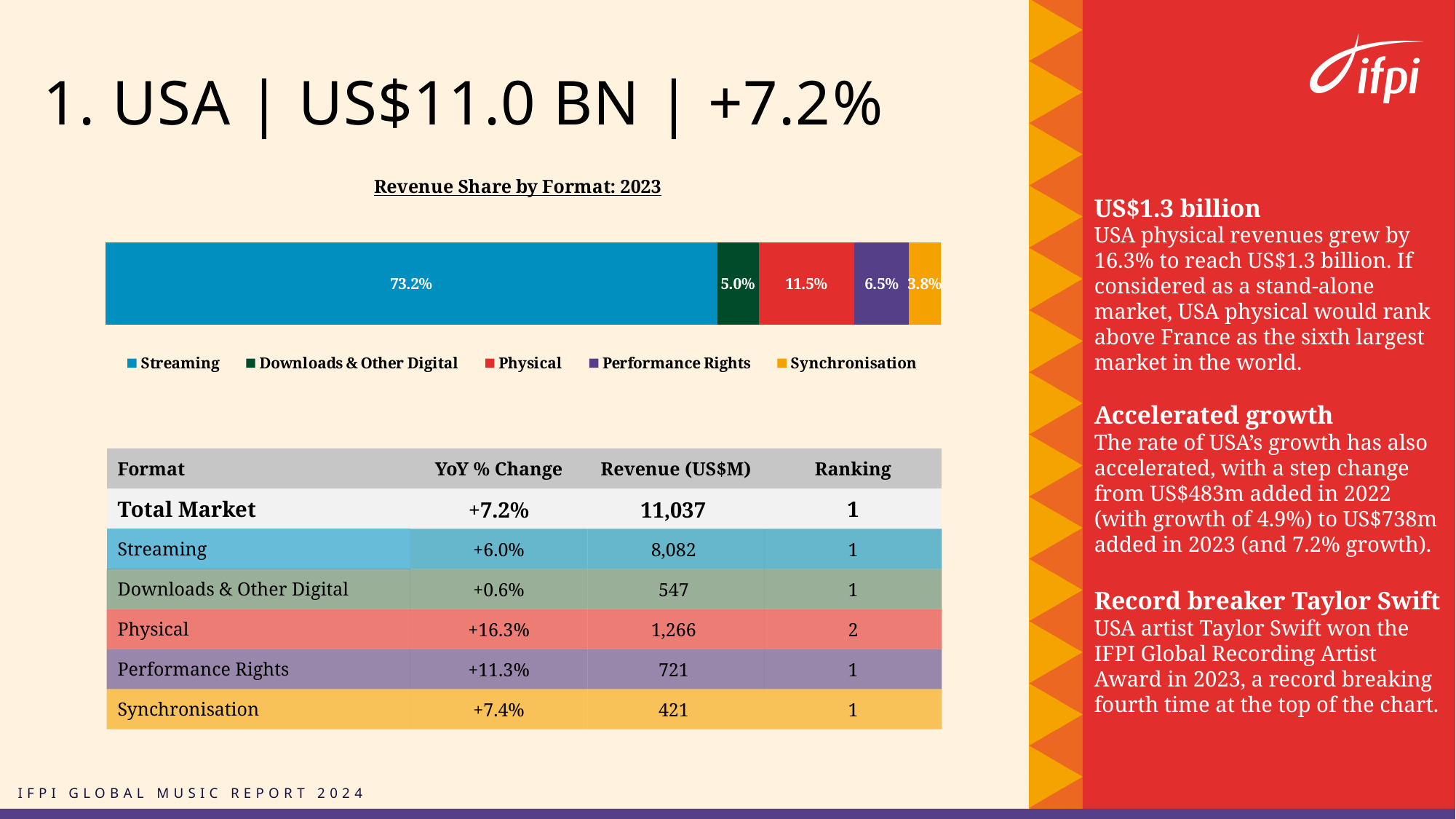
How many series does the legend of the Revenue Share by Format: 2023 chart list? 5 In the Revenue Share by Format: 2023 chart, what colour is the Synchronisation segment? Orange In the Revenue Share by Format: 2023 chart, what share does Synchronisation have? 3.8% In the Revenue Share by Format: 2023 chart, what share does Streaming have? 73.2% In the Revenue Share by Format: 2023 chart, which format has the smallest share? Synchronisation In the Revenue Share by Format: 2023 chart, what share does Performance Rights have? 6.5% In the Revenue Share by Format: 2023 chart, which format has the largest share? Streaming What kind of chart is the Revenue Share by Format: 2023 chart? Stacked bar chart In the Revenue Share by Format: 2023 chart, which has the larger share, Physical or Downloads & Other Digital? Physical In the Revenue Share by Format: 2023 chart, what share does Physical have? 11.5% In the Revenue Share by Format: 2023 chart, what is the difference in percentage points between the Physical share and the Performance Rights share? 5.0 In the Revenue Share by Format: 2023 chart, what share does Downloads & Other Digital have? 5.0%